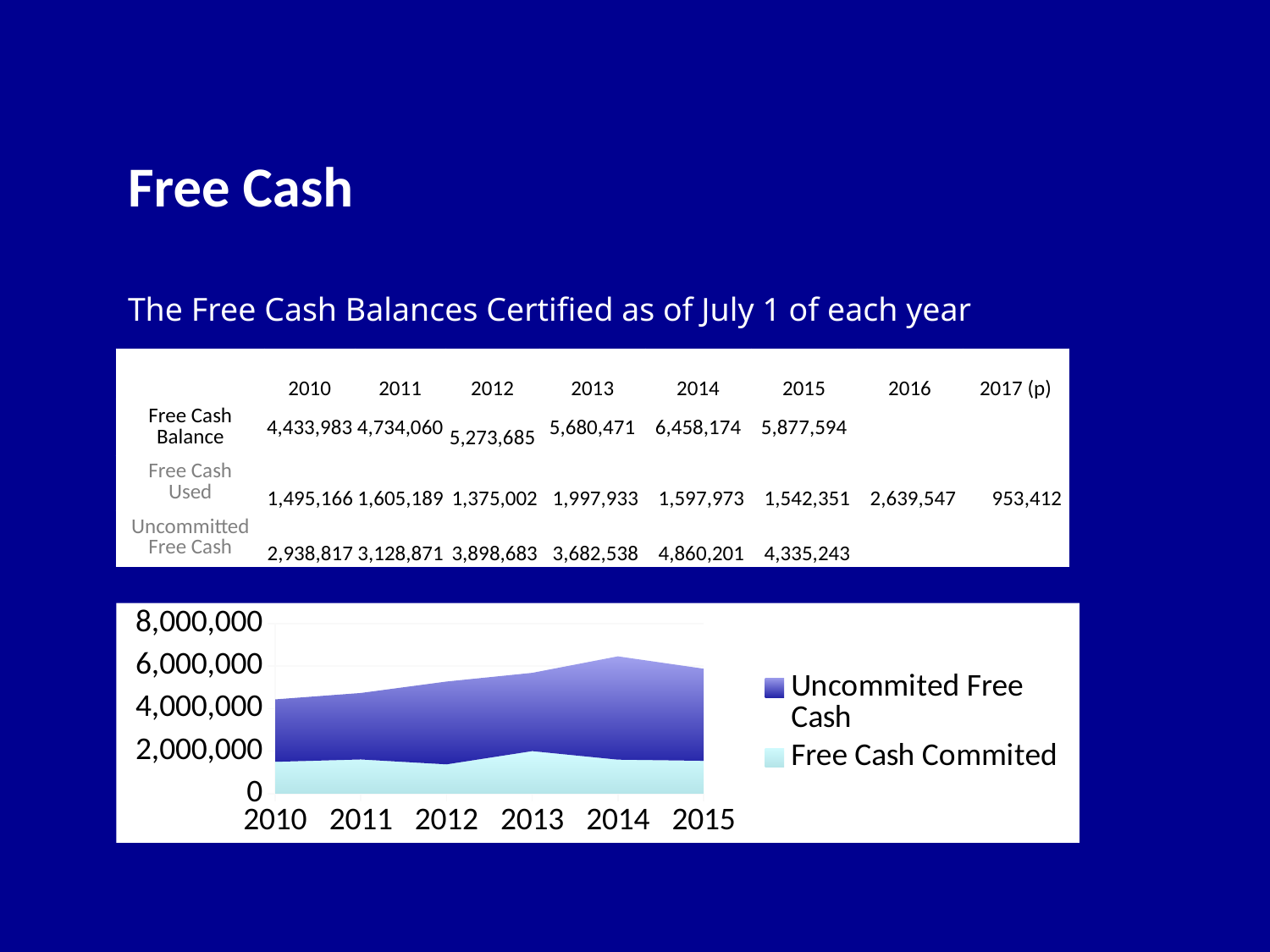
What kind of chart is shown on the slide? area chart Is the value for Free Cash Commited in 2012 greater or less than 2,000,000? less According to the table, what is the Free Cash Balance for 2013? 5,680,471 How many years are shown along the x axis of the chart? 6 In which year does the stacked total in the chart reach its highest point? 2014 In which year is the stacked total in the chart lowest? 2010 How many series does the chart legend list? 2 Is the stacked total for 2014 greater or less than 6,000,000? greater Does the stacked total in the chart rise or fall from 2010 to 2014? rise Which series is shown in light blue in the chart? Free Cash Commited According to the table, what is the Uncommitted Free Cash value for 2014? 4,860,201 What is the first entry listed in the chart legend? Uncommited Free Cash